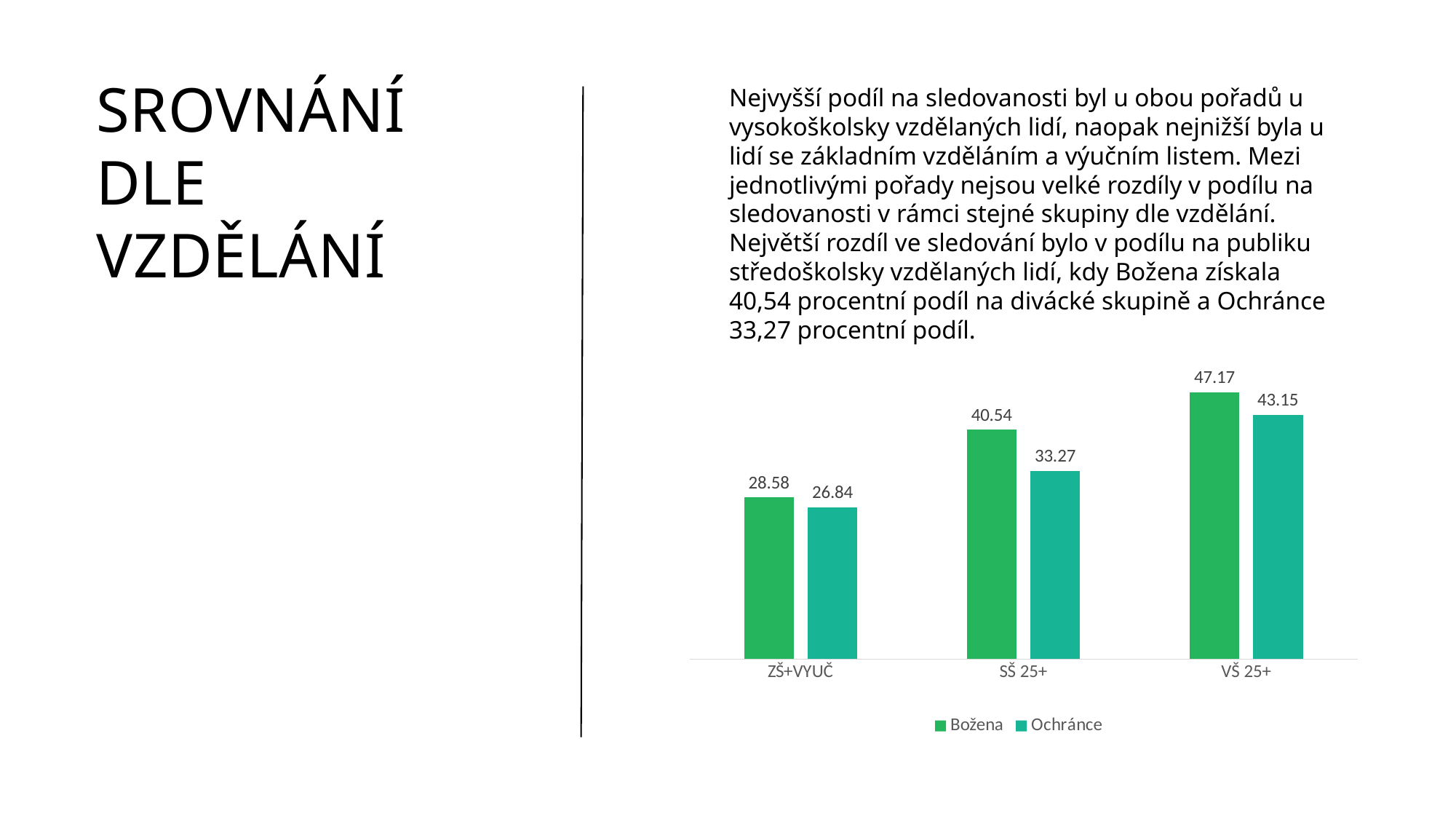
What is the value for Ochránce in the SŠ 25+ category? 33.27 Do the values for Božena rise or fall from ZŠ+VYUČ to VŠ 25+? rise Which category has the lowest value for Ochránce? ZŠ+VYUČ What is the value for Božena in the ZŠ+VYUČ category? 28.58 What is the difference between Božena and Ochránce in the SŠ 25+ category? 7.27 Which category has the highest value for Božena? VŠ 25+ How many categories are shown on the x axis? 3 What is the value for Ochránce in the VŠ 25+ category? 43.15 Which is larger in the VŠ 25+ category, Božena or Ochránce? Božena What are the two series named in the legend? Božena and Ochránce How many series does the legend list? 2 What kind of chart is shown on the slide? bar chart